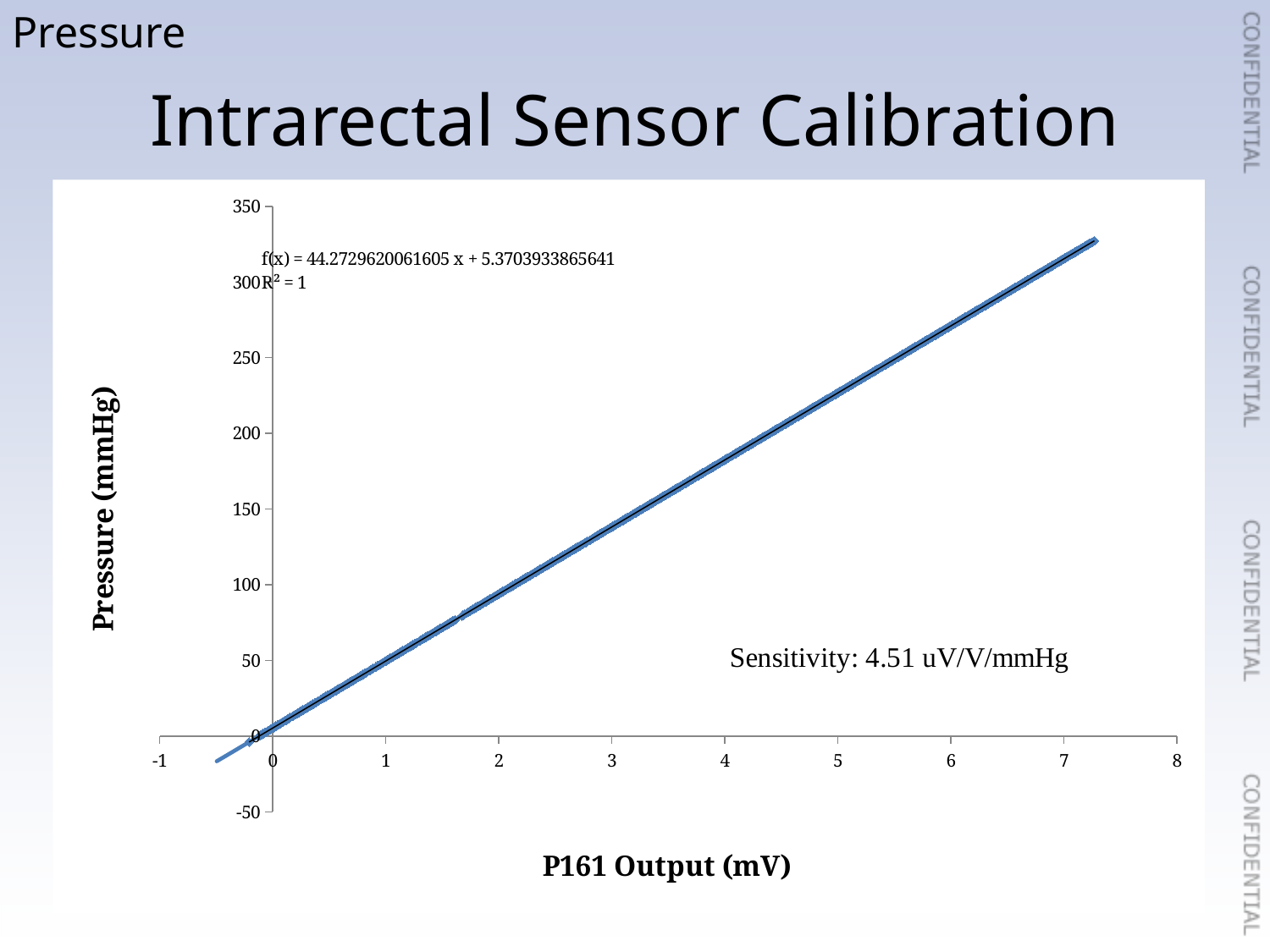
What is the highest value shown on the y axis? 350 Is the pressure at a P161 output of 6 mV greater or less than 250 mmHg? greater Is the pressure at a P161 output of 7 mV greater or less than 300 mmHg? greater What sensitivity value is printed on the chart? 4.51 uV/V/mmHg Does pressure rise or fall as P161 output increases along the x axis? Rises Is the pressure at a P161 output of 4 mV greater or less than 150 mmHg? greater What is the trendline equation shown on the chart? f(x) = 44.2729620061605 x + 5.3703933865641 What is the label of the x axis? P161 Output (mV) What is the R² value shown for the trendline? R² = 1 What kind of chart is shown on the slide? Scatter chart with a linear trendline What is the label of the y axis? Pressure (mmHg)